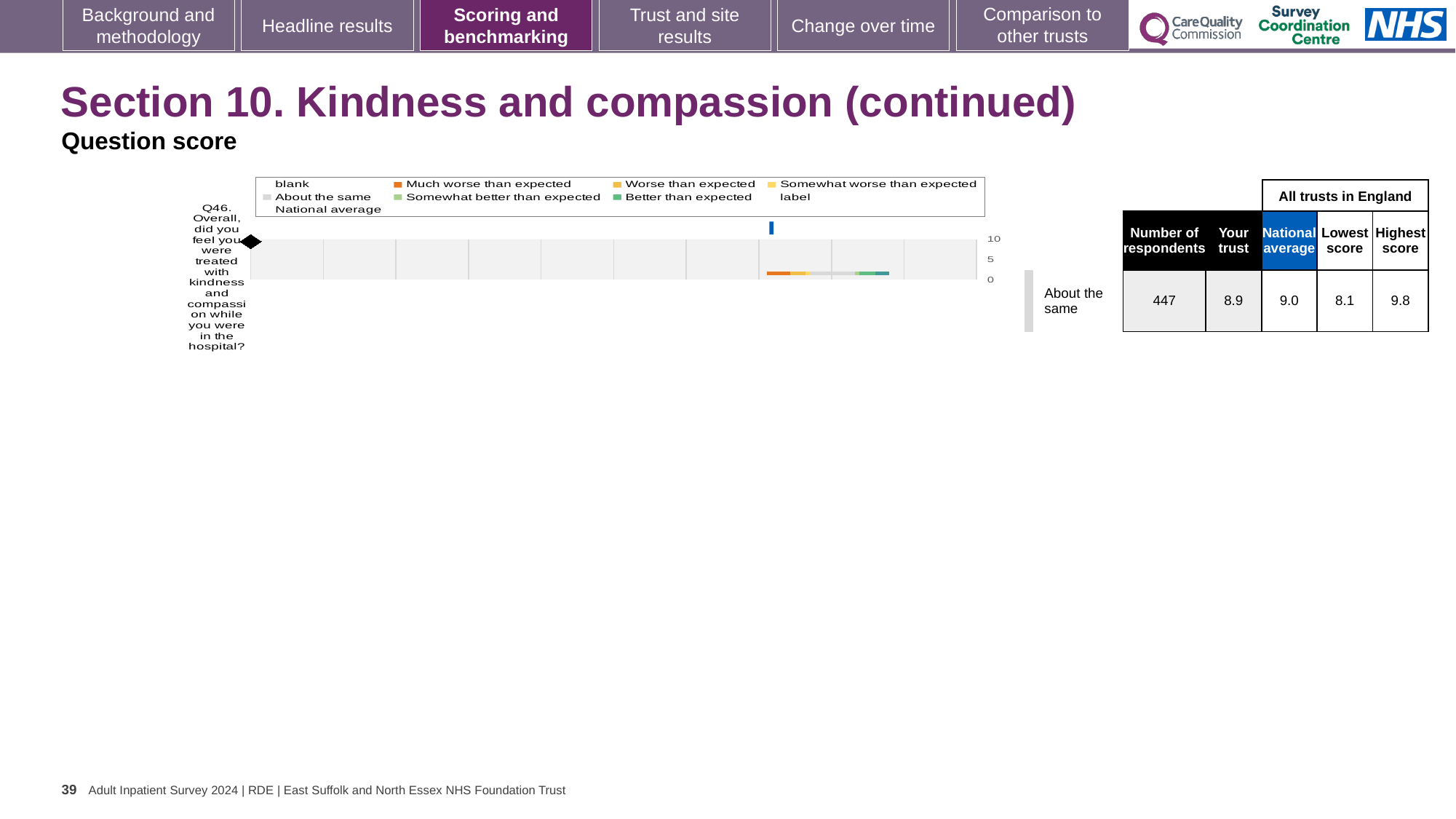
Is the Your trust score for Q46 greater or less than 5 on the chart's axis? greater What is the difference between the National average score and the Your trust score? 0.1 What is the National average score shown in the table? 9.0 What is the Lowest score among all trusts in England shown in the table? 8.1 What is the Highest score among all trusts in England shown in the table? 9.8 What kind of chart is shown on the slide? bar chart How many respondents are shown in the table for Q46? 447 What is the score for Your trust in the table next to the chart? 8.9 What is the highest tick value shown on the chart's score axis? 10 What is the difference between the Highest score and the Lowest score in the table? 1.7 Which question number is plotted on the chart? Q46 Which is larger, the Your trust score or the National average score? National average